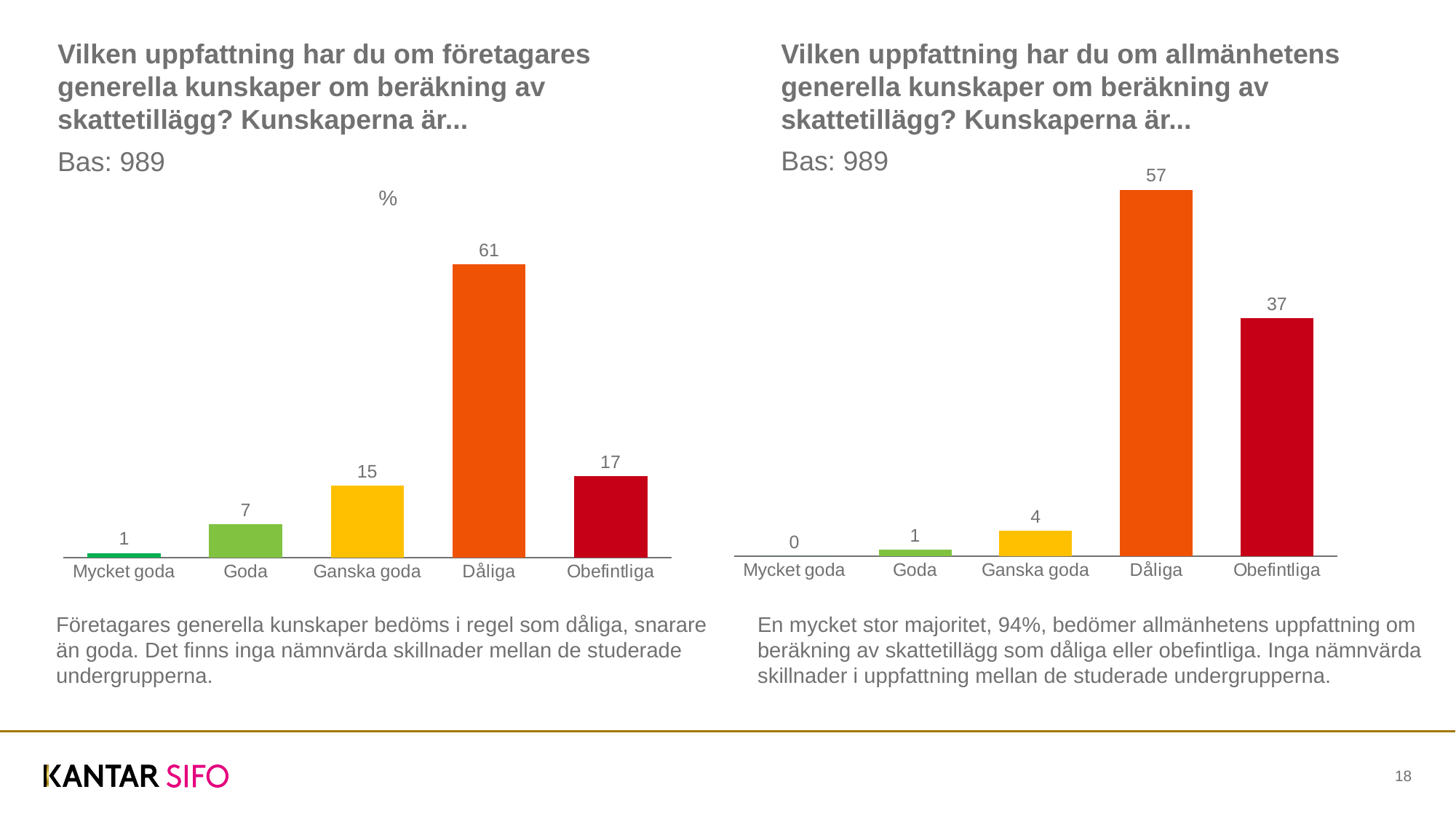
How many categories are shown in the left chart (företagares generella kunskaper)? 5 In the left chart (företagares generella kunskaper), which is larger: Goda or Ganska goda? Ganska goda In the left chart (företagares generella kunskaper), what is the difference between Dåliga and Obefintliga? 44 In the left chart (företagares generella kunskaper), what is the value for Mycket goda? 1 In the right chart (allmänhetens generella kunskaper), what is the difference between Dåliga and Obefintliga? 20 In the right chart (allmänhetens generella kunskaper), which category has the lowest value? Mycket goda In the left chart (företagares generella kunskaper), what is the value for Dåliga? 61 In the right chart (allmänhetens generella kunskaper), what is the value for Obefintliga? 37 What kind of chart is the right chart (allmänhetens generella kunskaper)? Bar chart In the right chart (allmänhetens generella kunskaper), what is the value for Ganska goda? 4 What is the base (Bas) shown for the right chart (allmänhetens generella kunskaper)? 989 In the left chart (företagares generella kunskaper), which category has the highest value? Dåliga